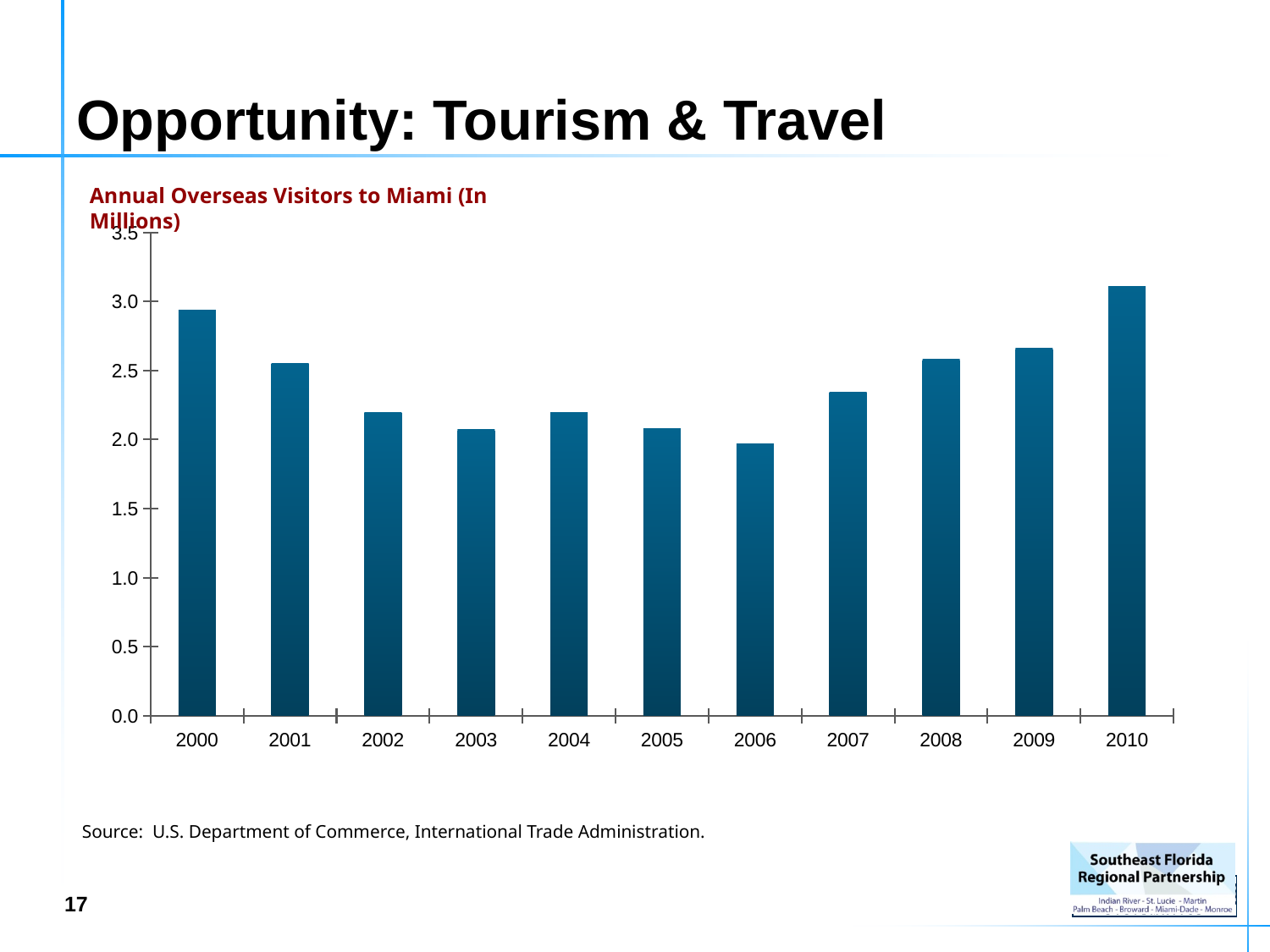
Is the value for 2000 greater or less than 3.0? less Is the value for 2010 greater or less than 3.0? greater Which year has more overseas visitors, 2007 or 2009? 2009 Which year has more overseas visitors, 2000 or 2001? 2000 Which year has the lowest number of overseas visitors to Miami? 2006 Which year has the highest number of overseas visitors to Miami? 2010 What type of chart is shown on the slide? Bar chart What is the title of the chart? Annual Overseas Visitors to Miami (In Millions) How many years are shown on the x axis of the chart? 11 Is the value for 2007 greater or less than 2.5? less Do the values rise or fall from 2006 to 2010? rise